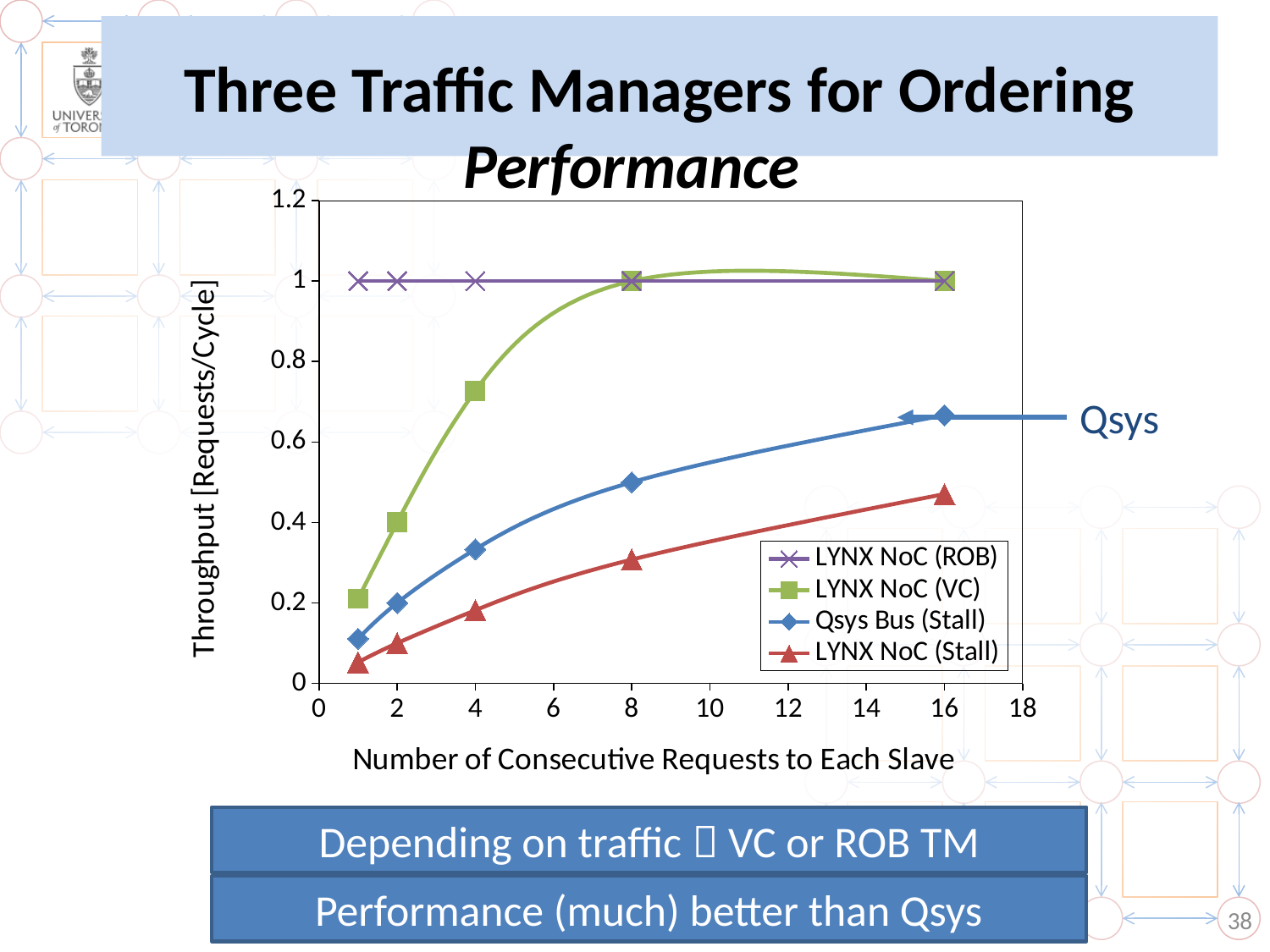
How many data points are plotted for the Qsys Bus (Stall) series? 5 What is the throughput of LYNX NoC (VC) at 16 consecutive requests to each slave? 1 What kind of chart is shown on the slide? line chart At 4 consecutive requests, which series has the higher throughput: LYNX NoC (VC) or Qsys Bus (Stall)? LYNX NoC (VC) How many series does the legend list? 4 Is the throughput of LYNX NoC (Stall) at 16 consecutive requests greater or less than 0.6? less What is the title of the x axis? Number of Consecutive Requests to Each Slave Does the throughput of Qsys Bus (Stall) rise or fall as the number of consecutive requests increases? rise Is the throughput of Qsys Bus (Stall) at 16 consecutive requests greater or less than 0.6? greater What is the throughput of LYNX NoC (ROB) at 2 consecutive requests to each slave? 1 Which series has the lowest throughput at 16 consecutive requests to each slave? LYNX NoC (Stall) Is the throughput of LYNX NoC (VC) at 4 consecutive requests greater or less than 0.6? greater